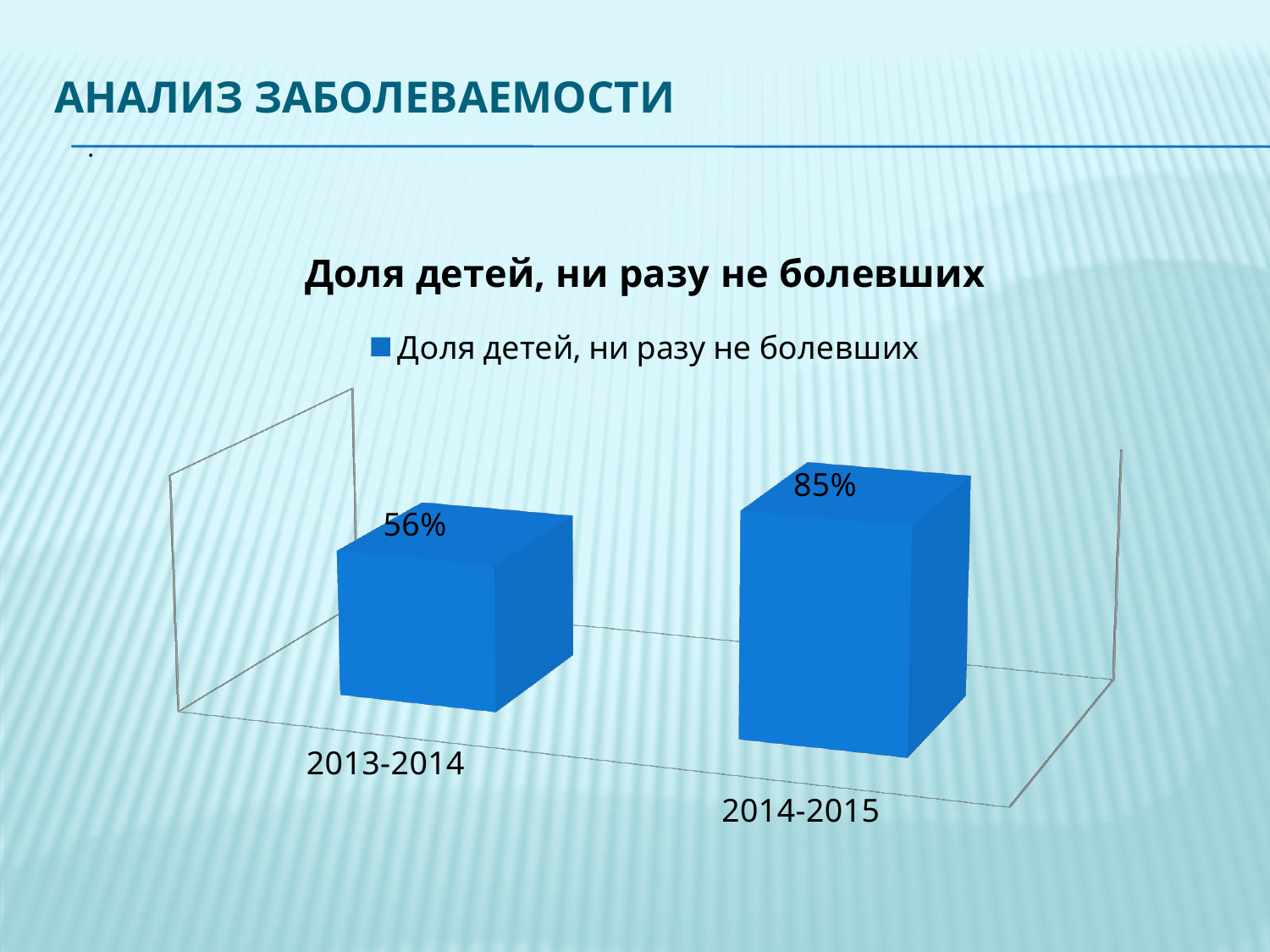
What series name is listed in the legend? Доля детей, ни разу не болевших How many categories are shown on the chart? 2 Which is larger, the value for 2013-2014 or the value for 2014-2015? 2014-2015 Do the values rise or fall from 2013-2014 to 2014-2015? Rise How many series does the legend list? 1 What is the title of the chart? Доля детей, ни разу не болевших Which category has the lowest value? 2013-2014 What is the value for 2014-2015? 85% Which category has the highest value? 2014-2015 What is the value for 2013-2014? 56% What is the difference between the values for 2014-2015 and 2013-2014? 29% What kind of chart is shown on the slide? Bar chart